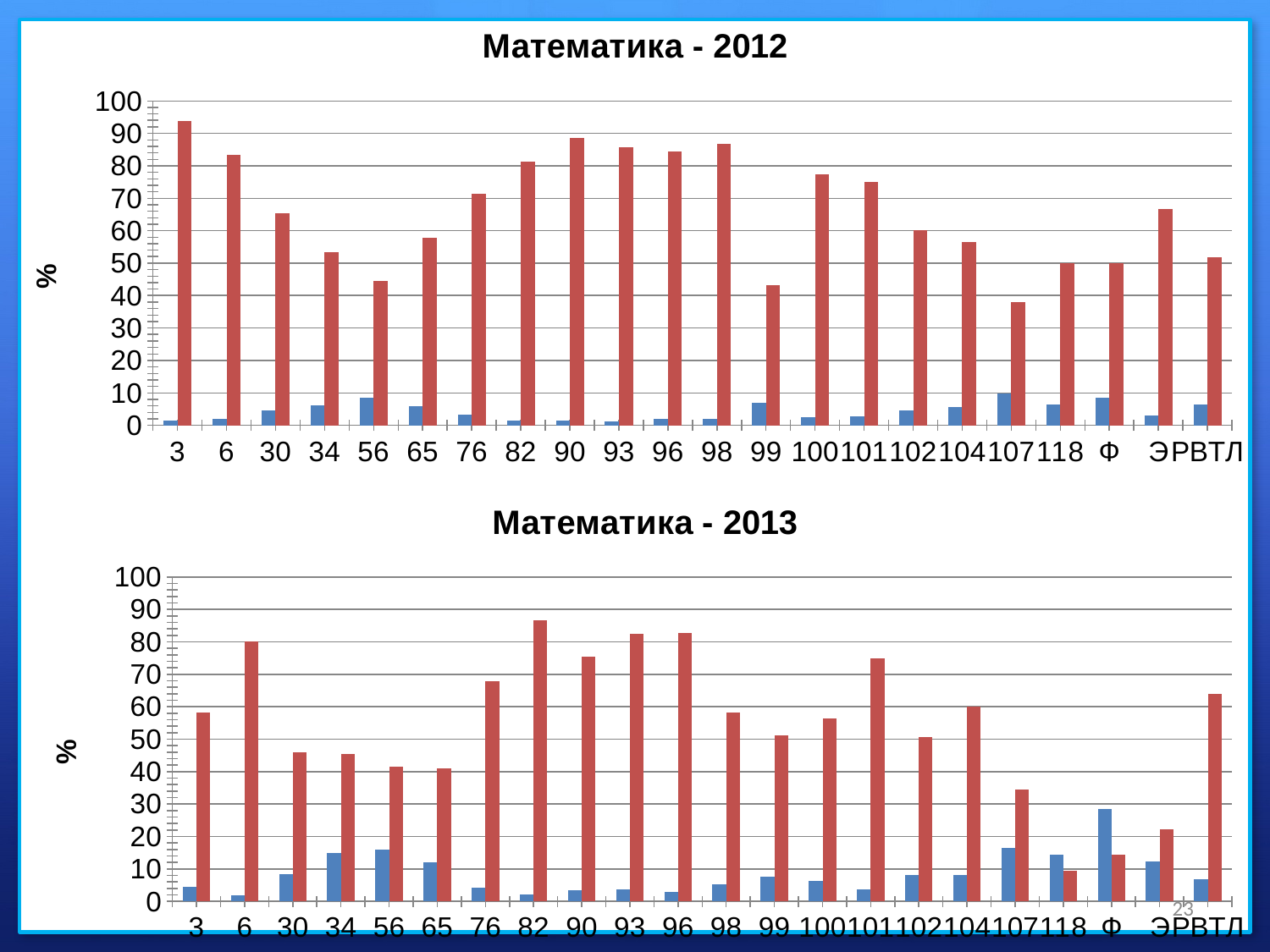
What is the label on the y axis of the 'Математика - 2013' chart? % What kind of chart is the 'Математика - 2012' chart? bar chart In the 'Математика - 2012' chart, is the red bar for category 107 greater or less than 40? less In the 'Математика - 2013' chart, which category has the tallest red bar? 82 In the 'Математика - 2012' chart, which red bar is taller: category 3 or category 6? 3 In the 'Математика - 2013' chart, is the blue bar for category Ф greater or less than 20? greater In the 'Математика - 2012' chart, is the red bar for category 3 greater or less than 90? greater In the 'Математика - 2012' chart, which category has the shortest red bar? 107 In the 'Математика - 2013' chart, which red bar is taller: category 82 or category 90? 82 In the 'Математика - 2012' chart, which category has the tallest red bar? 3 How many categories are shown on the x axis of the 'Математика - 2013' chart? 22 In the 'Математика - 2013' chart, which category has the shortest red bar? 118